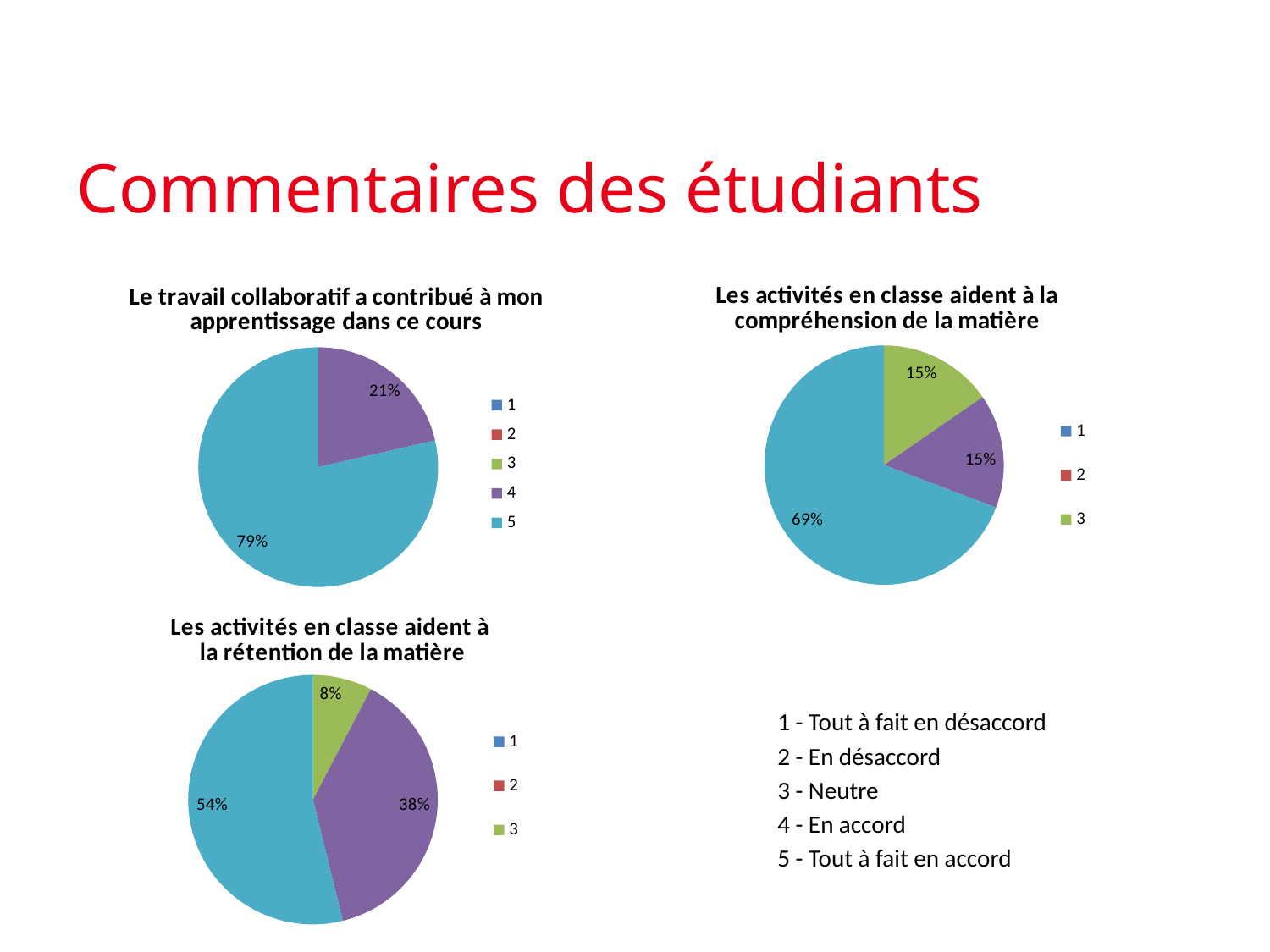
In the chart titled 'Les activités en classe aident à la rétention de la matière', what percentage is shown for the purple slice? 38% How many pie charts are shown on the slide? 3 In the chart titled 'Les activités en classe aident à la rétention de la matière', what is the difference in percentage points between the teal slice and the purple slice? 16 What kind of chart is used for 'Les activités en classe aident à la compréhension de la matière'? Pie chart In the chart titled 'Les activités en classe aident à la compréhension de la matière', what percentage is shown for the largest slice? 69% In the chart titled 'Les activités en classe aident à la rétention de la matière', which slice is larger: the teal one or the purple one? The teal one In the chart titled 'Le travail collaboratif a contribué à mon apprentissage dans ce cours', what percentage is shown for the purple slice? 21% How many entries does the legend list in the chart titled 'Le travail collaboratif a contribué à mon apprentissage dans ce cours'? 5 How many slices are there in the chart titled 'Les activités en classe aident à la compréhension de la matière'? 3 In the chart titled 'Les activités en classe aident à la rétention de la matière', what percentage is shown for the smallest slice? 8% In the chart titled 'Les activités en classe aident à la compréhension de la matière', what percentage is shown for the green slice? 15% In the chart titled 'Le travail collaboratif a contribué à mon apprentissage dans ce cours', what percentage is shown for the largest (teal) slice? 79%